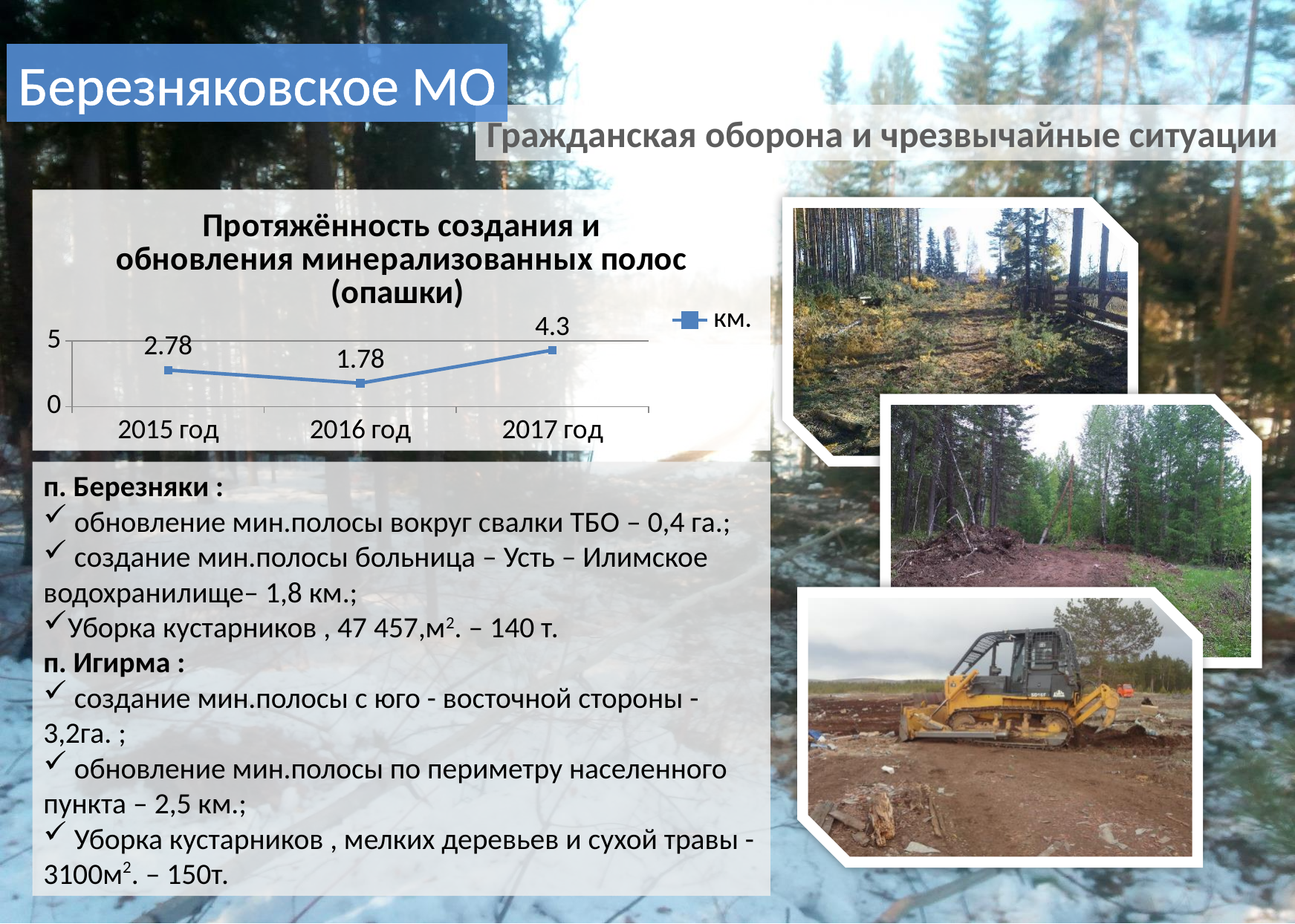
Which year has the lowest value? 2016 год What is the value for 2015 год? 2.78 What is the value for 2016 год? 1.78 What is the difference between the values for 2015 год and 2016 год? 1 What kind of chart is shown on the slide? line chart What is the value for 2017 год? 4.3 How many data points are plotted on the chart? 3 Which is larger, the value for 2015 год or the value for 2017 год? 2017 год What is the legend entry of the series on the chart? км. What is the difference between the values for 2017 год and 2016 год? 2.52 How many series does the legend list? 1 Which year has the highest value? 2017 год